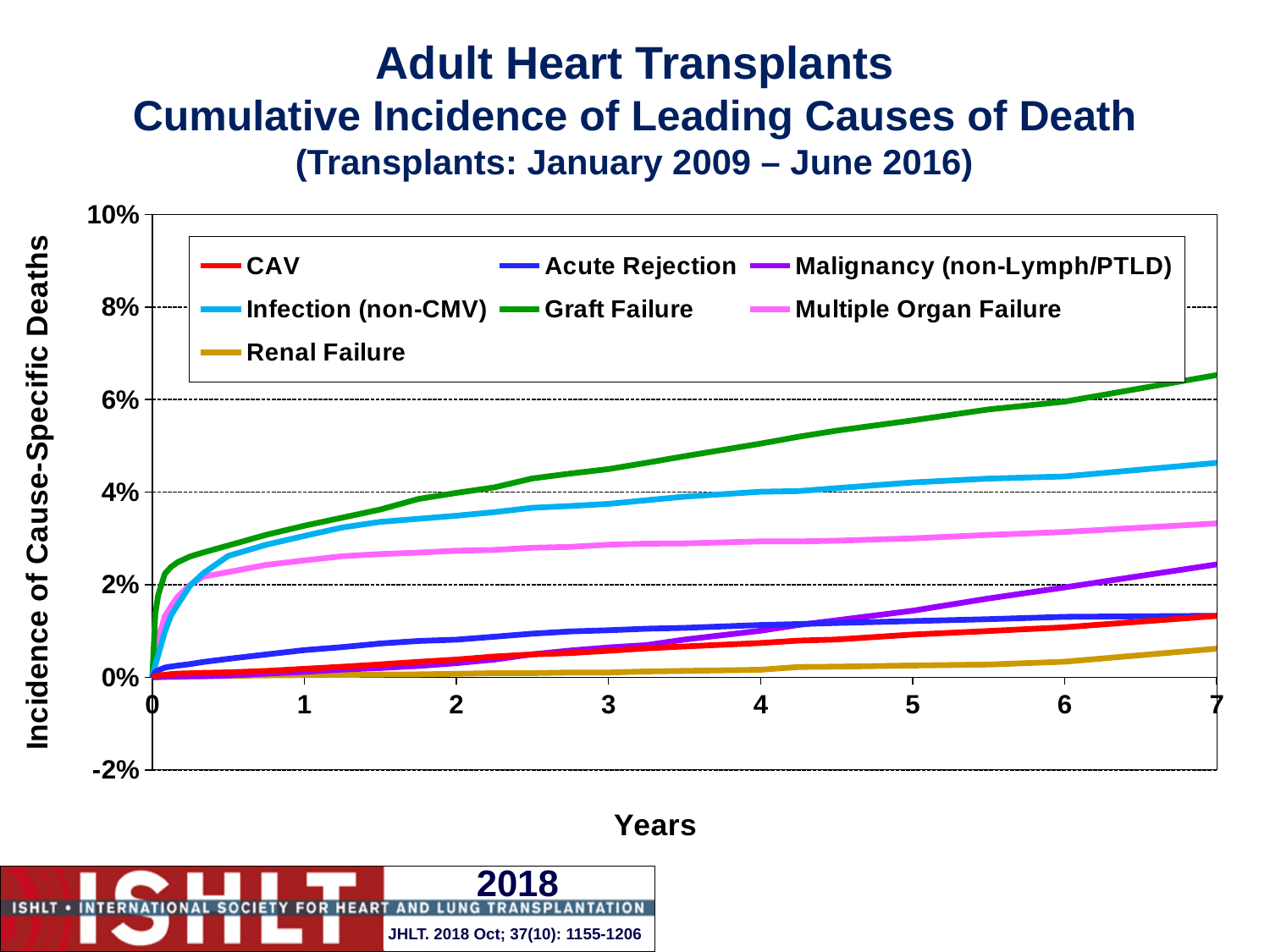
Which is larger at 7 years, Graft Failure or Infection (non-CMV)? Graft Failure Is the value for Multiple Organ Failure at 7 years greater or less than 4%? less Is the value for Graft Failure at 7 years greater or less than 6%? greater Which is larger at 7 years, Multiple Organ Failure or CAV? Multiple Organ Failure How many series does the legend list? 7 What is the label of the x axis? Years Which cause of death has the highest cumulative incidence at 7 years? Graft Failure Does the Graft Failure line rise or fall as years increase? rise Which cause of death has the lowest cumulative incidence at 7 years? Renal Failure Is the value for Renal Failure at 7 years greater or less than 2%? less What kind of chart is shown on the slide? line chart